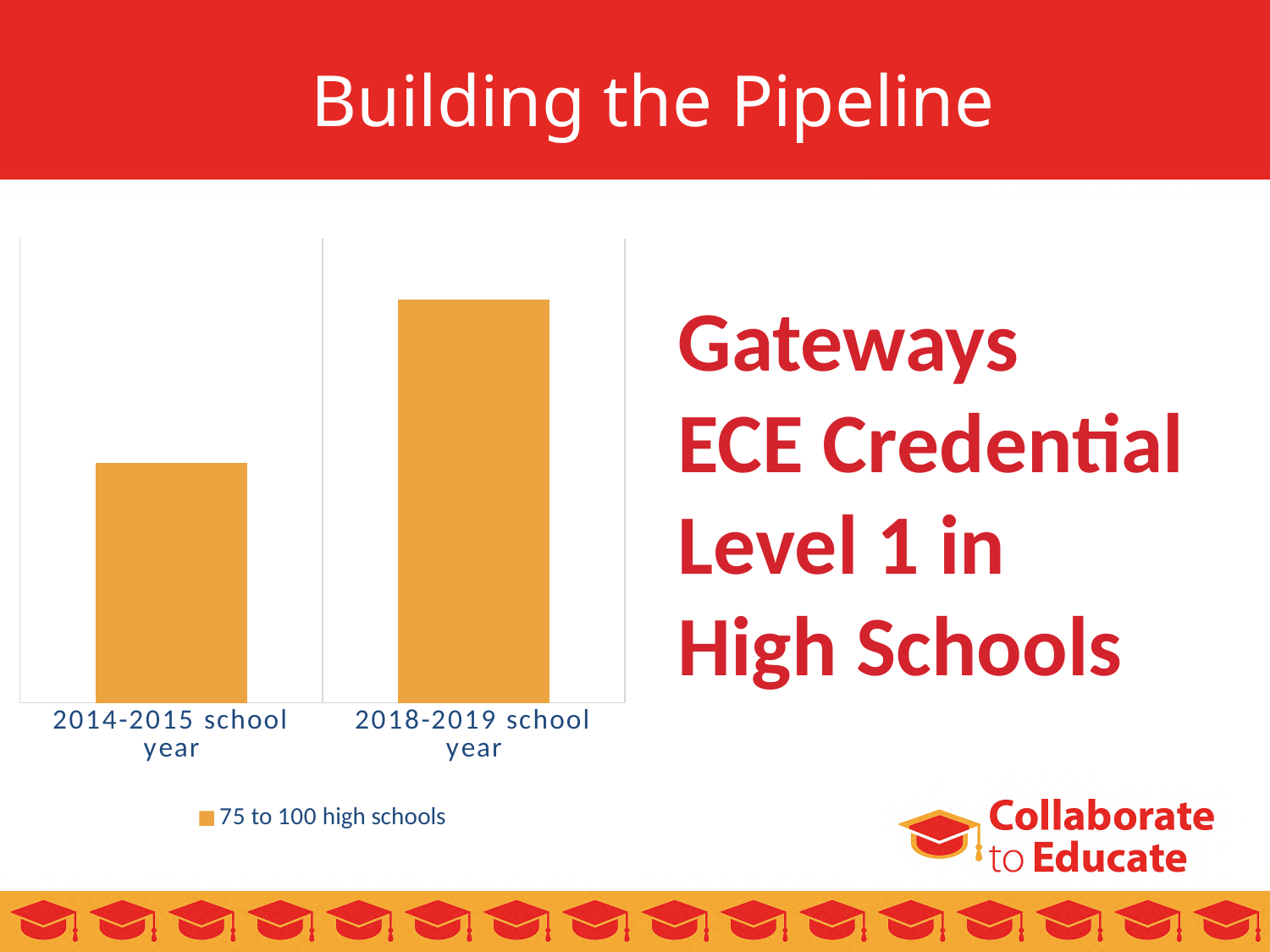
How many categories are plotted on the x axis of the chart? 2 What colour are the bars in the chart? orange How many series does the chart's legend list? 1 What is the series name shown in the chart's legend? 75 to 100 high schools Which bar is taller: 2014-2015 school year or 2018-2019 school year? 2018-2019 school year Do the values rise or fall from the 2014-2015 school year to the 2018-2019 school year? rise Which category has the highest bar in the chart? 2018-2019 school year What kind of chart is shown on the slide? bar chart Which category has the lowest bar in the chart? 2014-2015 school year